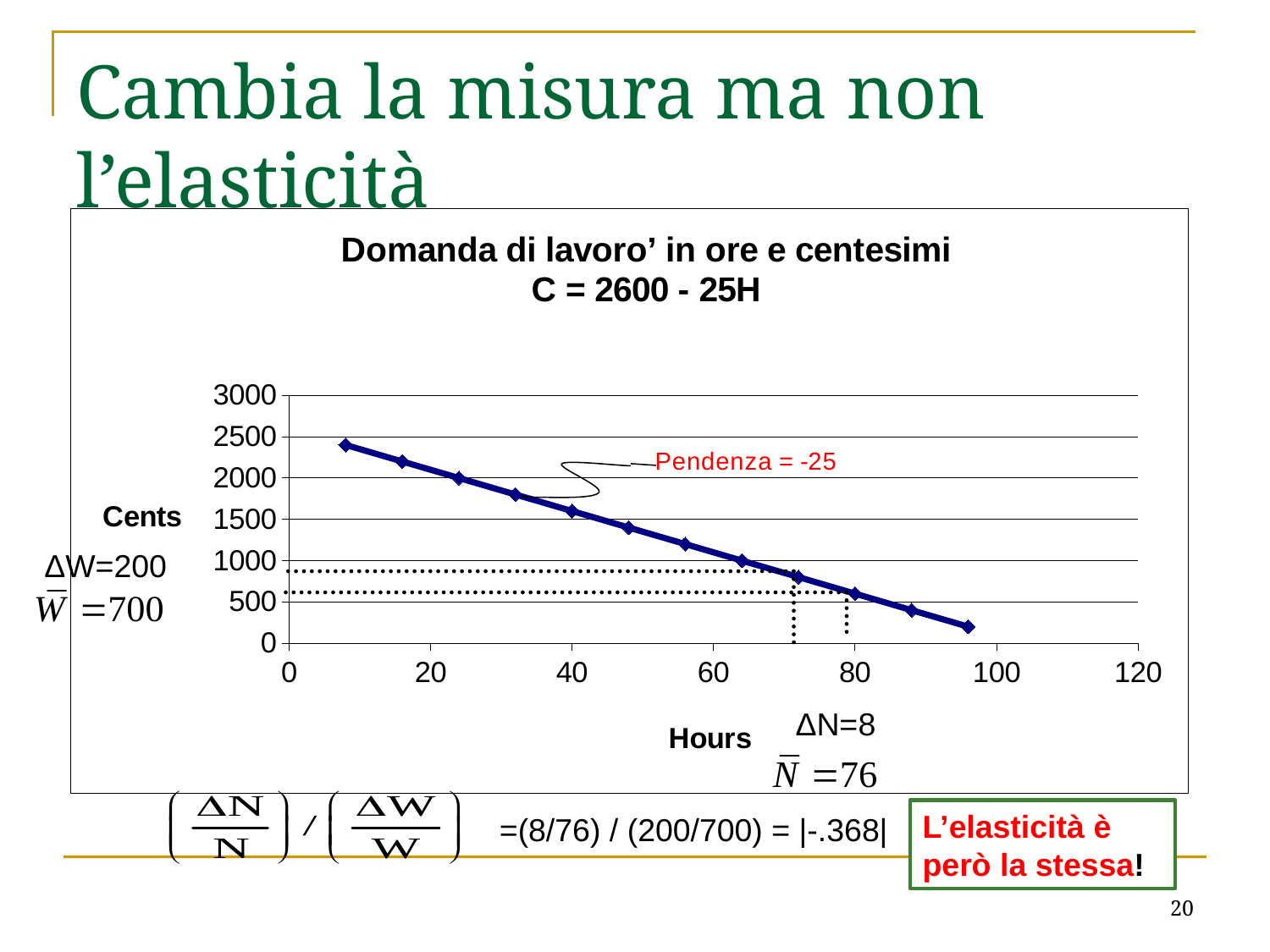
Is the value in Cents for the leftmost plotted point greater or less than 2000? greater Is the value in Cents at about 56 hours greater or less than 1000? greater What slope (Pendenza) is annotated on the chart? -25 Is the value in Cents for the rightmost plotted point greater or less than 500? less What is the label of the vertical axis? Cents How many data points are plotted on the line? 12 What is the title of the chart? Domanda di lavoro' in ore e centesimi C = 2600 - 25H What kind of chart is shown on the slide? line chart Which plotted point has the larger Cents value: the one near 20 hours or the one near 100 hours? the one near 20 hours Do the values in Cents rise or fall as Hours increase along the x axis? fall